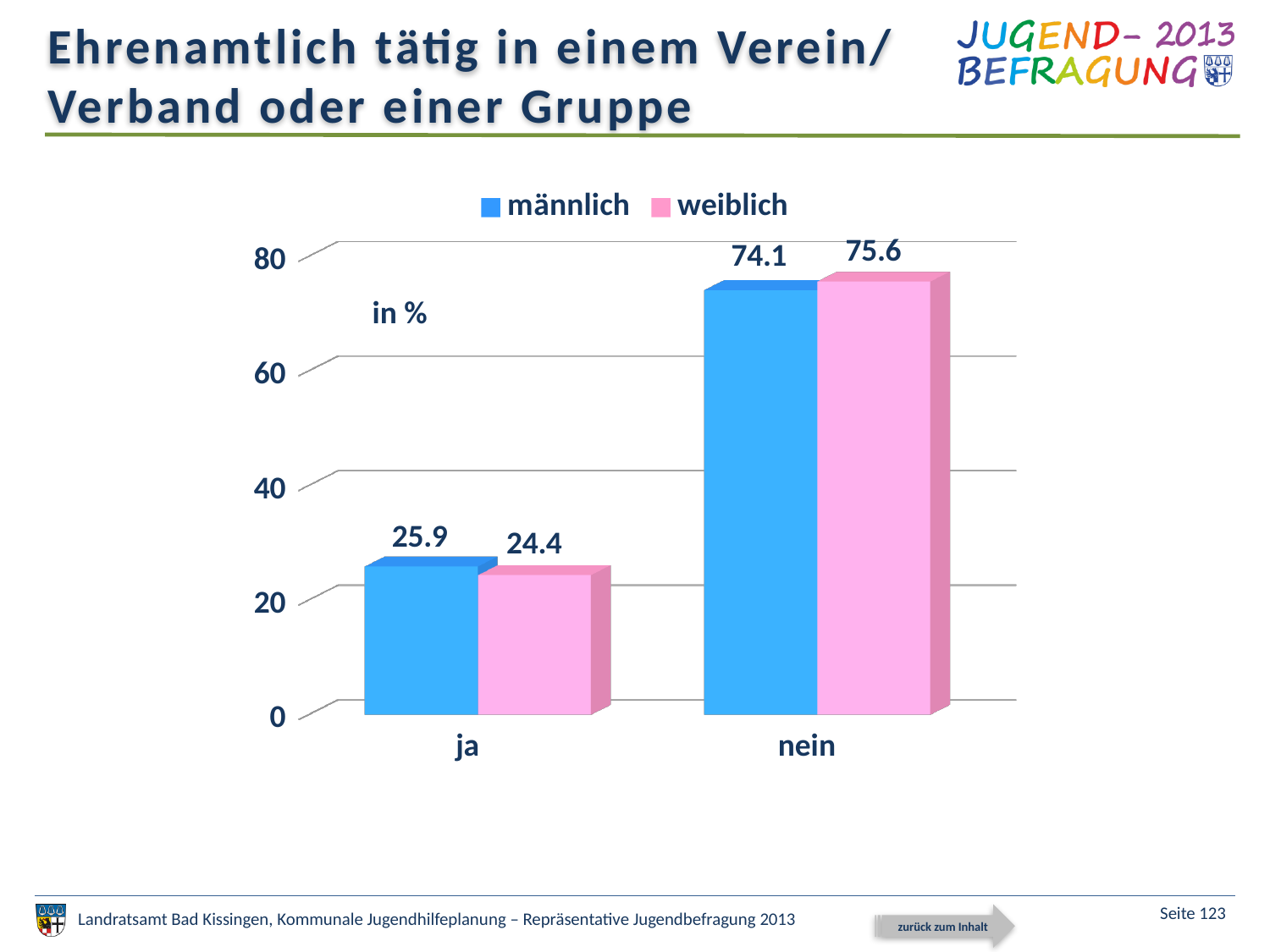
Which category has the highest value for weiblich? nein What is the difference between the männlich and weiblich values in the ja category? 1.5 How many categories are shown on the x axis? 2 What is the value for weiblich in the ja category? 24.4 Which is larger in the ja category, männlich or weiblich? männlich How many series does the legend list? 2 What is the value for weiblich in the nein category? 75.6 What is the difference between the weiblich and männlich values in the nein category? 1.5 What is the value for männlich in the nein category? 74.1 Which category has the lowest value for männlich? ja What kind of chart is shown on the slide? bar chart What is the value for männlich in the ja category? 25.9